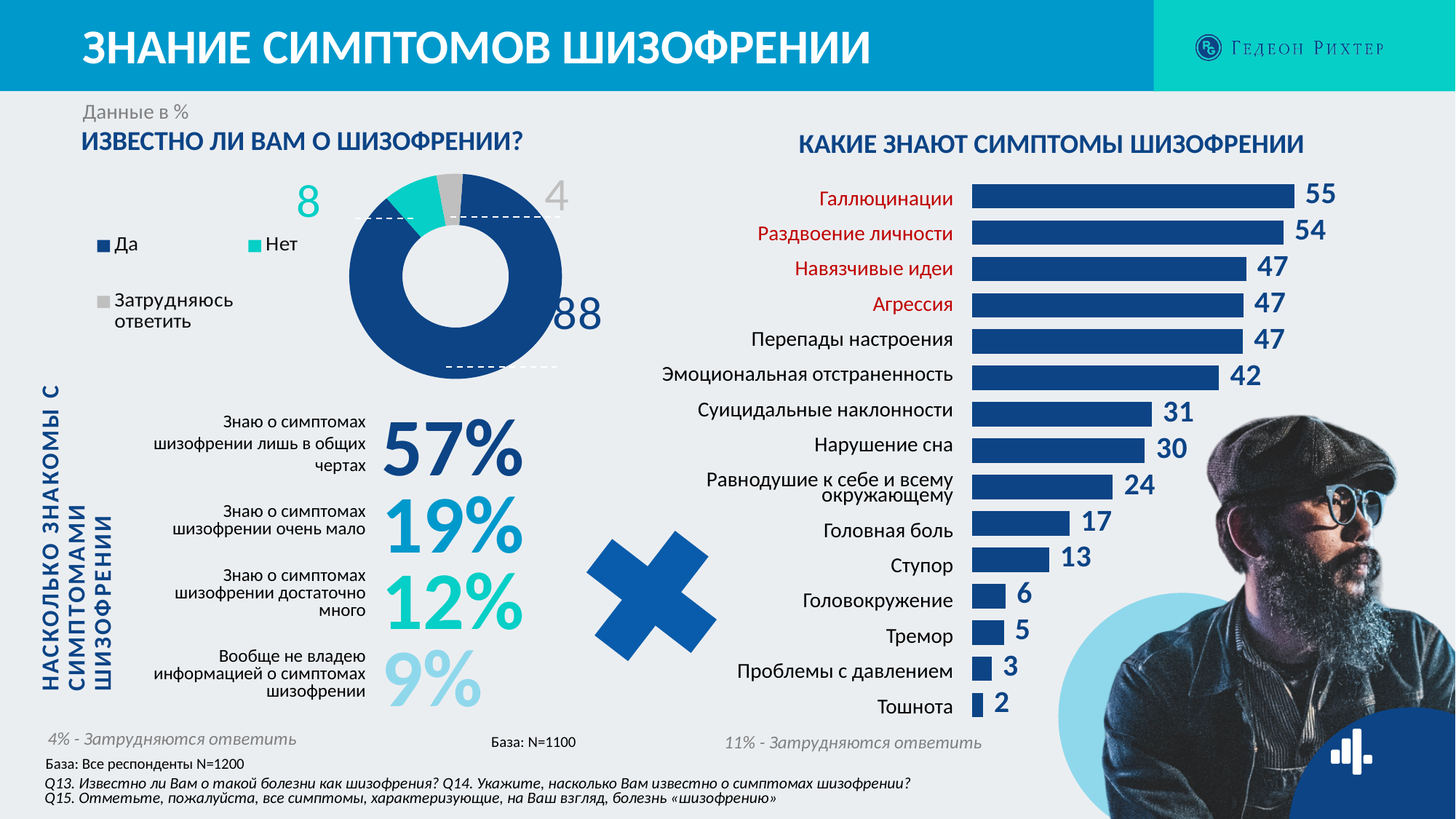
In the donut chart 'ИЗВЕСТНО ЛИ ВАМ О ШИЗОФРЕНИИ?', what is the value for Да? 88 In the donut chart 'ИЗВЕСТНО ЛИ ВАМ О ШИЗОФРЕНИИ?', what is the difference between the values for Да and Нет? 80 In the chart 'КАКИЕ ЗНАЮТ СИМПТОМЫ ШИЗОФРЕНИИ', which symptom has the highest value? Галлюцинации In the chart 'КАКИЕ ЗНАЮТ СИМПТОМЫ ШИЗОФРЕНИИ', what is the value for Нарушение сна? 30 In the chart 'КАКИЕ ЗНАЮТ СИМПТОМЫ ШИЗОФРЕНИИ', which symptom has the lowest value? Тошнота In the chart 'КАКИЕ ЗНАЮТ СИМПТОМЫ ШИЗОФРЕНИИ', what is the value for Галлюцинации? 55 In the chart 'КАКИЕ ЗНАЮТ СИМПТОМЫ ШИЗОФРЕНИИ', what is the difference between the values for Эмоциональная отстраненность and Суицидальные наклонности? 11 In the donut chart 'ИЗВЕСТНО ЛИ ВАМ О ШИЗОФРЕНИИ?', what is the value for Нет? 8 How many symptoms are listed in the chart 'КАКИЕ ЗНАЮТ СИМПТОМЫ ШИЗОФРЕНИИ'? 15 How many entries does the legend of the donut chart 'ИЗВЕСТНО ЛИ ВАМ О ШИЗОФРЕНИИ?' list? 3 What kind of chart is 'КАКИЕ ЗНАЮТ СИМПТОМЫ ШИЗОФРЕНИИ'? Bar chart In the chart 'КАКИЕ ЗНАЮТ СИМПТОМЫ ШИЗОФРЕНИИ', which is larger: the value for Головная боль or the value for Ступор? Головная боль